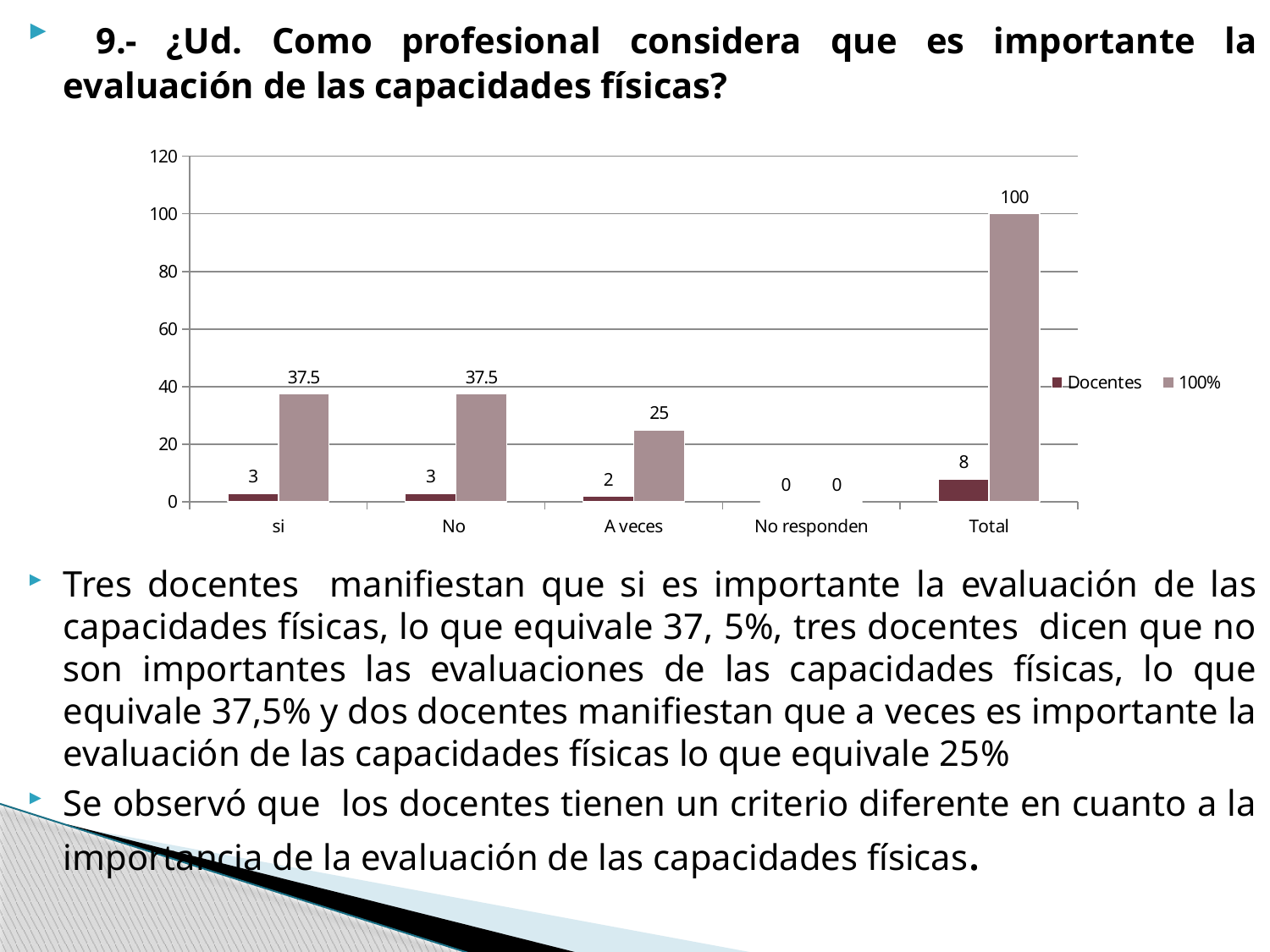
Which category has the lowest Docentes value? No responden What is the 100% value for the 'No' category? 37.5 What kind of chart is shown on the slide? Bar chart How many series does the legend list? 2 How many categories are shown on the x axis? 5 Which is larger, the 100% value for 'No' or for 'A veces'? No What is the Docentes value for the 'si' category? 3 What is the Docentes value for the 'Total' category? 8 Which category has the highest 100% value? Total What is the 100% value for the 'A veces' category? 25 What are the two series names listed in the legend? Docentes and 100% What is the difference between the 100% values for 'si' and 'A veces'? 12.5